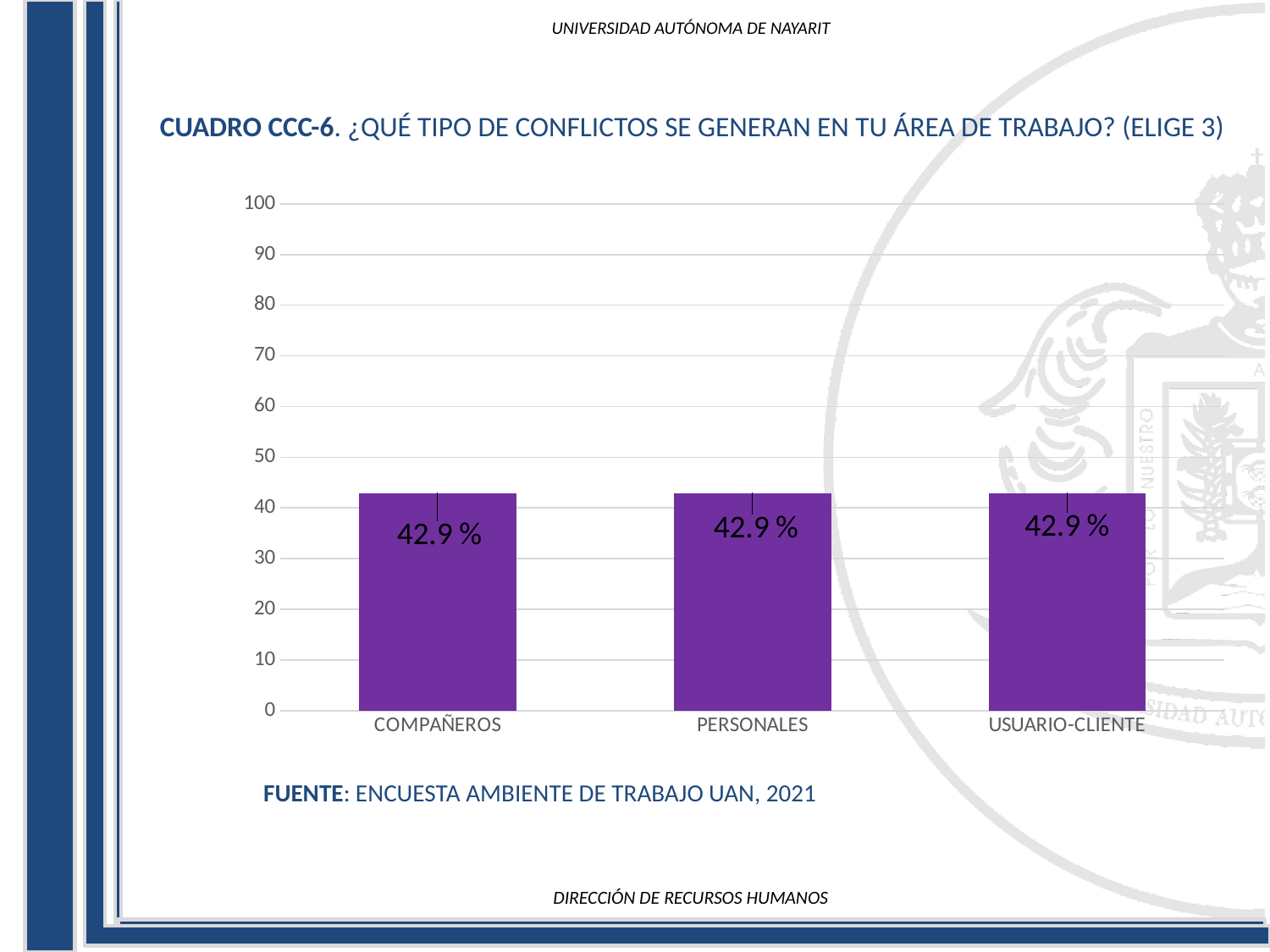
Is the value for COMPAÑEROS greater or less than 40? greater What is the value for COMPAÑEROS? 42.9 % What is the value for USUARIO-CLIENTE? 42.9 % What is the highest value shown on the y axis? 100 Do the values rise, fall or stay the same across the categories from left to right? stay the same What colour are the bars in the chart? purple How many categories are shown on the x axis? 3 What is the value for PERSONALES? 42.9 % What is the difference between the values for COMPAÑEROS and PERSONALES? 0 What kind of chart is shown on the slide? bar chart Is the value for USUARIO-CLIENTE greater or less than 50? less